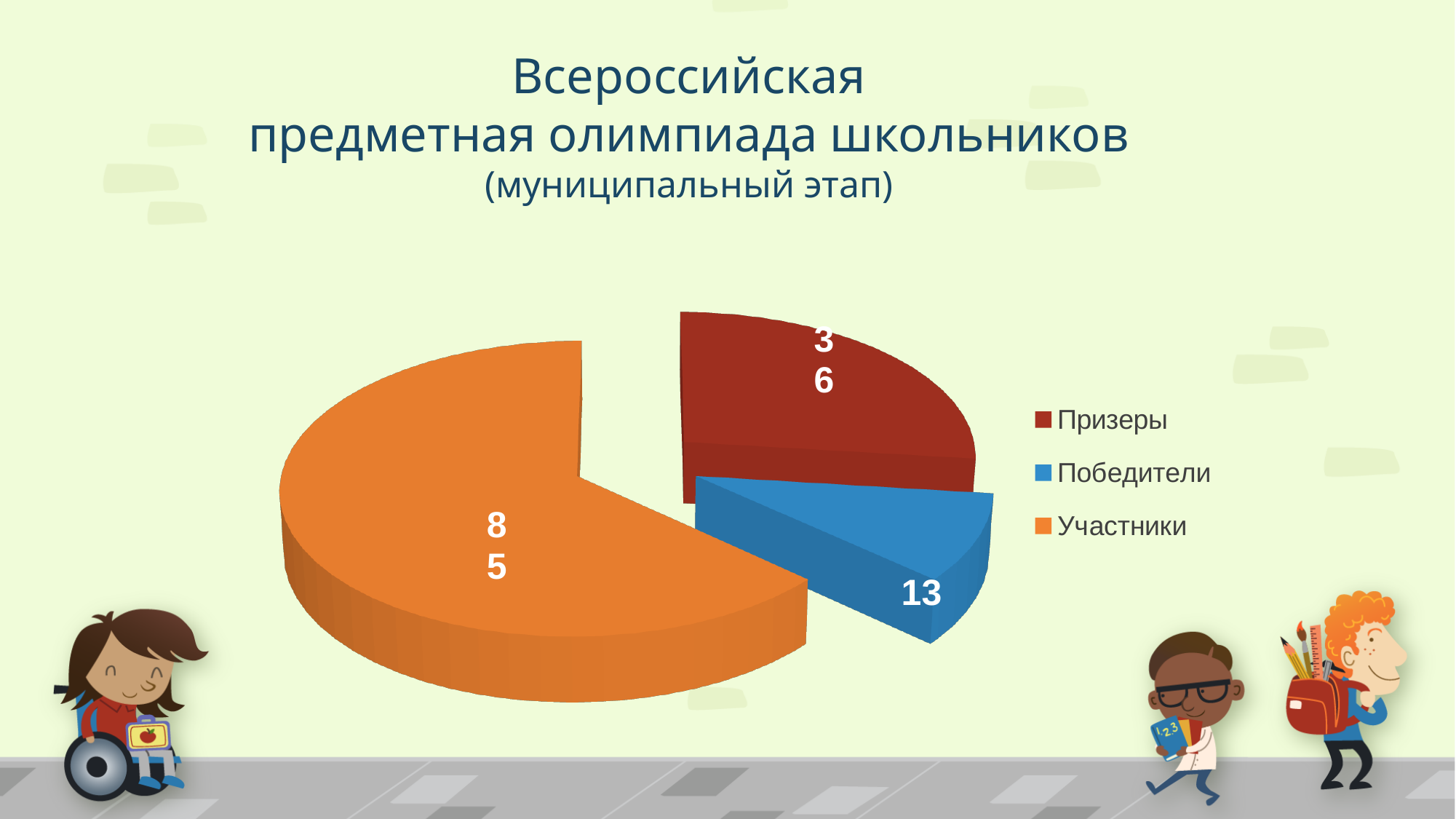
Which is larger, the value for Призеры or the value for Победители? Призеры What is the value for Участники? 85 Which category has the smallest slice? Победители Which colour represents Победители in the pie chart? blue What is the difference between the values for Призеры and Победители? 23 What kind of chart is shown on the slide? pie chart Which category has the largest slice? Участники What is the value for Призеры? 36 How many slices does the pie chart have? 3 What is the value for Победители? 13 How many entries does the legend list? 3 What is the total of all three slices? 134